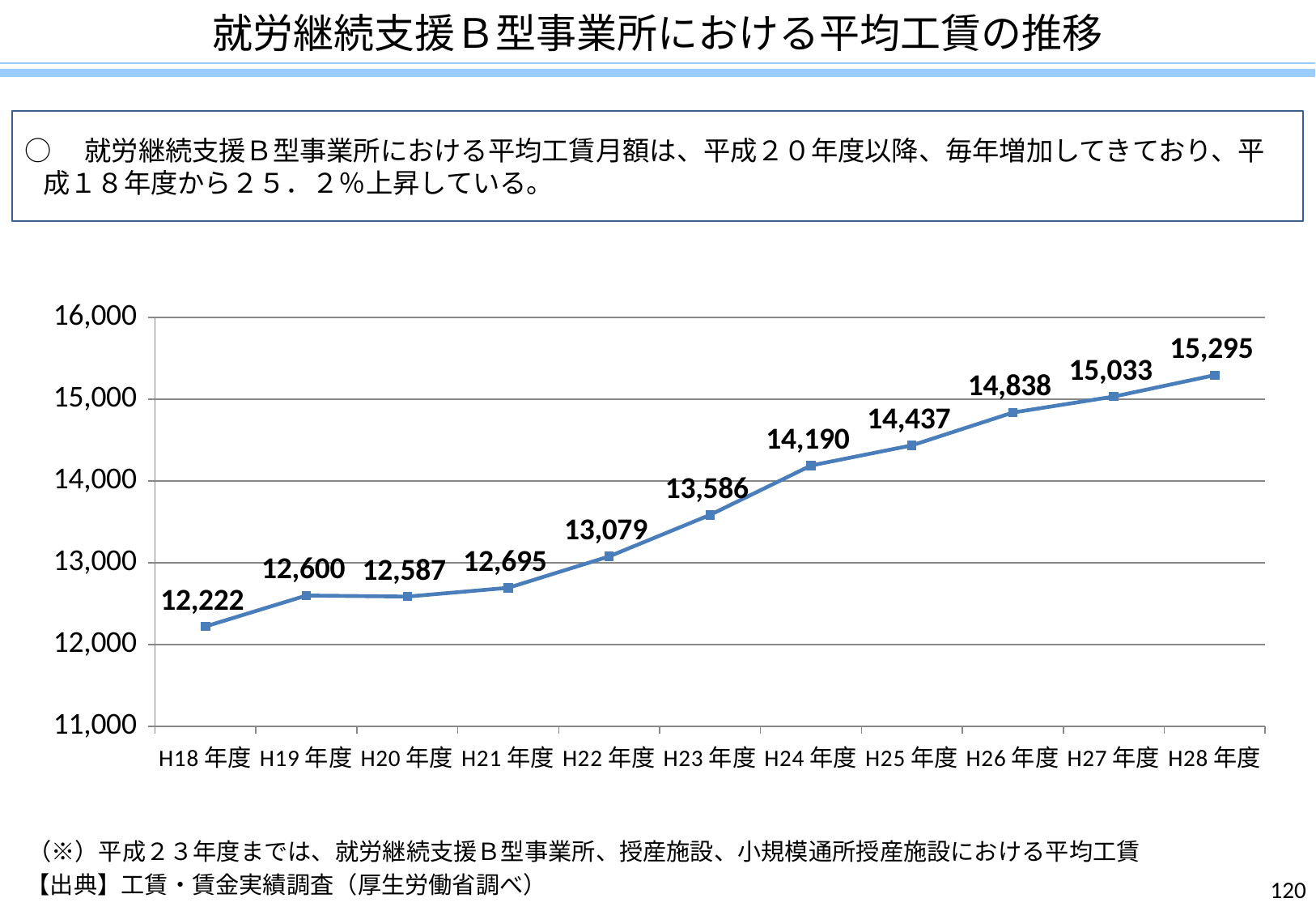
What is the difference between the values for H24年度 and H23年度? 604 What kind of chart is shown on the slide? line chart What is the average wage value for H18年度? 12,222 What is the difference between the values for H28年度 and H18年度? 3,073 What is the value plotted for H24年度? 14,190 Which is larger, the value for H19年度 or the value for H20年度? H19年度 What is the value plotted for H28年度? 15,295 Do the values generally rise or fall from H18年度 to H28年度? rise Which fiscal year has the highest value on the chart? H28年度 How many fiscal years are plotted on the chart? 11 Which fiscal year has the lowest value on the chart? H18年度 Is the value for H26年度 greater or less than 15,000? less